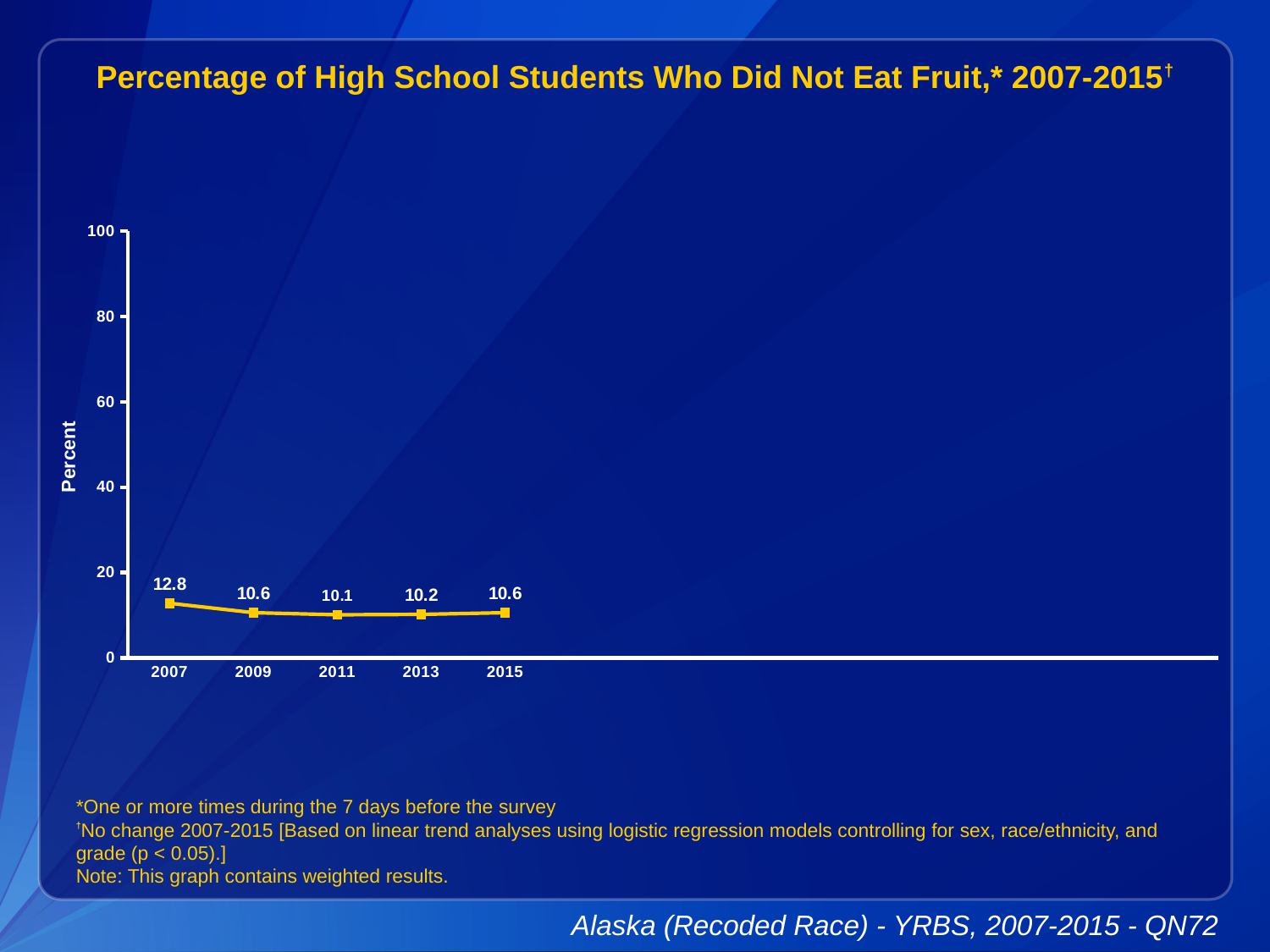
What is the value for 2015? 10.6 What is the difference between the values for 2007 and 2011? 2.7 What kind of chart is shown? line chart Is the value for 2009 greater or less than 20? less Which year has the highest value? 2007 What is the value for 2007? 12.8 What is the label on the y axis? Percent Does the value rise or fall from 2007 to 2009? fall What is the value for 2011? 10.1 Which year has the lowest value? 2011 Which is larger, the value for 2007 or the value for 2013? 2007 How many years are plotted on the chart? 5